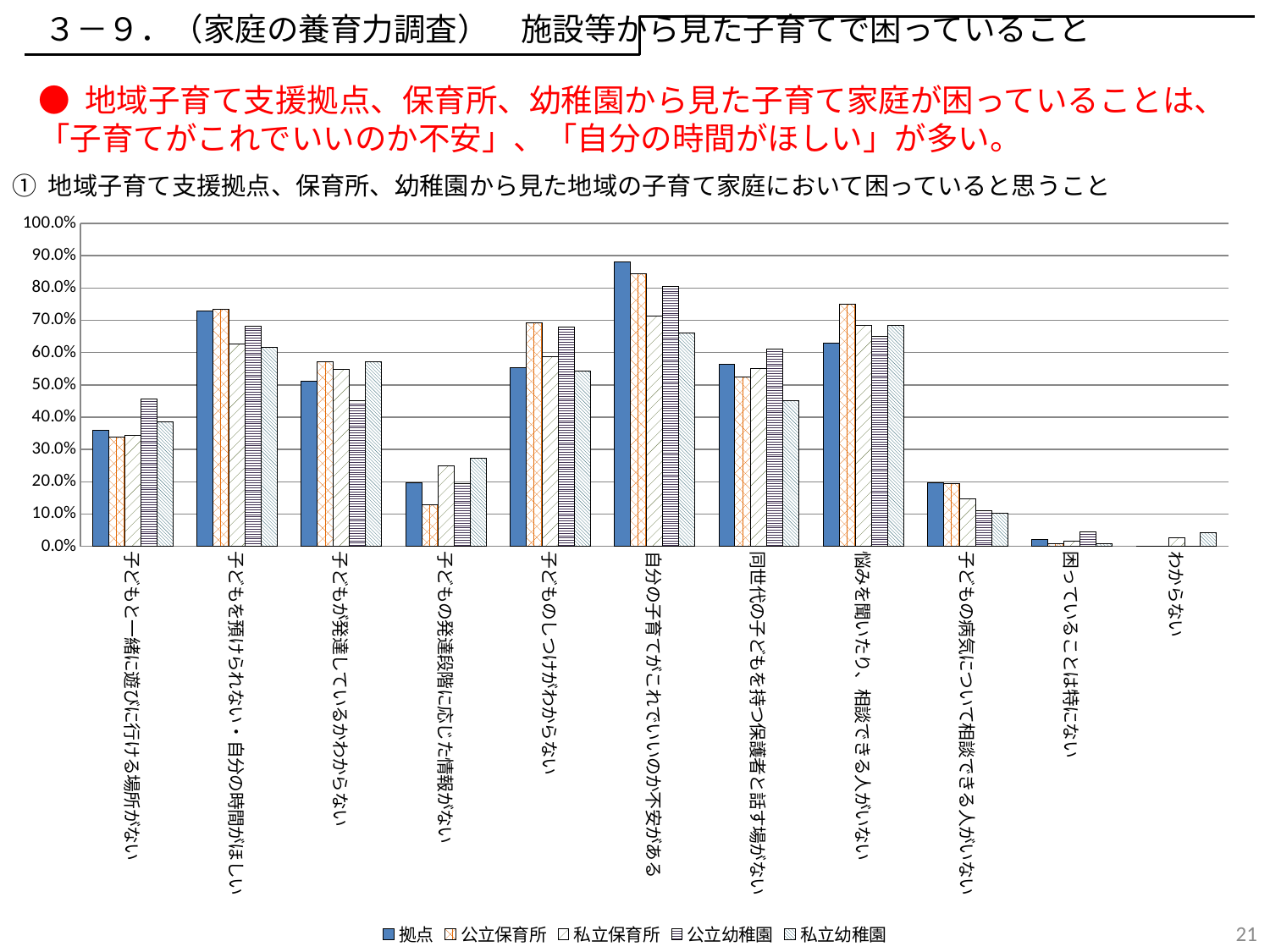
How many categories are shown on the x axis? 11 Is the value for 拠点 in the category 自分の子育てがこれでいいのか不安がある greater or less than 80.0%? greater Is the value for 拠点 in the category 子どもを預けられない・自分の時間がほしい greater or less than 60.0%? greater Is the value for 拠点 in the category 子どもの発達段階に応じた情報がない greater or less than 30.0%? less In the category 子どもと一緒に遊びに行ける場所がない, which is larger: 拠点 or 公立幼稚園? 公立幼稚園 What kind of chart is shown on the slide? bar chart Which series has the highest value in the category 悩みを聞いたり、相談できる人がいない? 公立保育所 In the category 自分の子育てがこれでいいのか不安がある, which is larger: 拠点 or 私立幼稚園? 拠点 What is the first series listed in the legend? 拠点 Which category has the highest value for the 拠点 series? 自分の子育てがこれでいいのか不安がある How many series does the legend list? 5